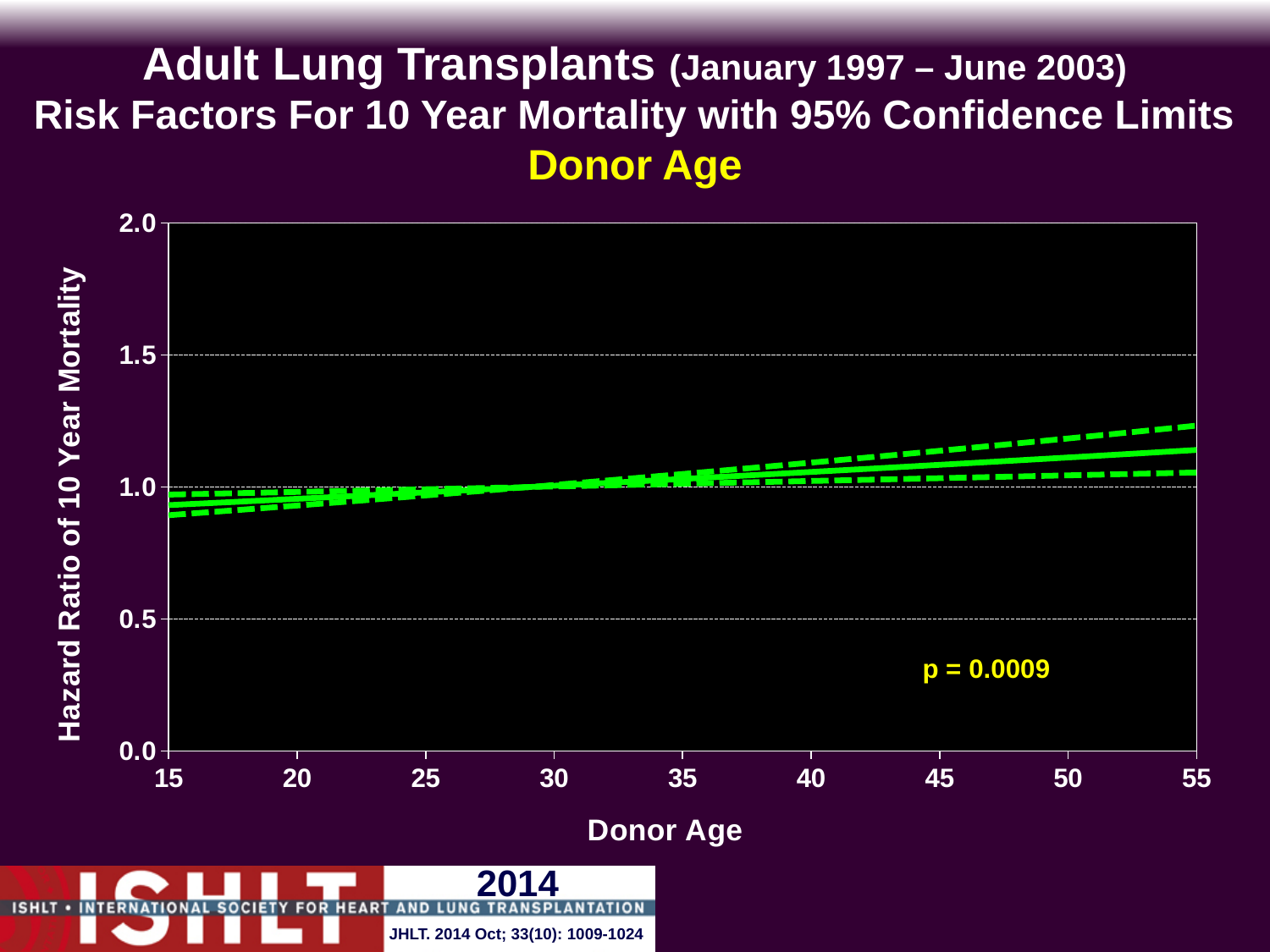
Which donor age has the higher hazard ratio, 20 or 50? 50 What is the label of the y axis? Hazard Ratio of 10 Year Mortality What kind of chart is shown on the slide? line chart What is the p-value shown on the chart? p = 0.0009 Does the hazard ratio of 10 year mortality rise or fall as donor age increases from 15 to 55? rise Is the upper 95% confidence limit at donor age 55 greater or less than 1.5? less How many tick marks are labelled on the Donor Age axis? 9 Is the hazard ratio for a donor age of 55 greater or less than 1.0? greater Is the hazard ratio for a donor age of 15 greater or less than 1.0? less